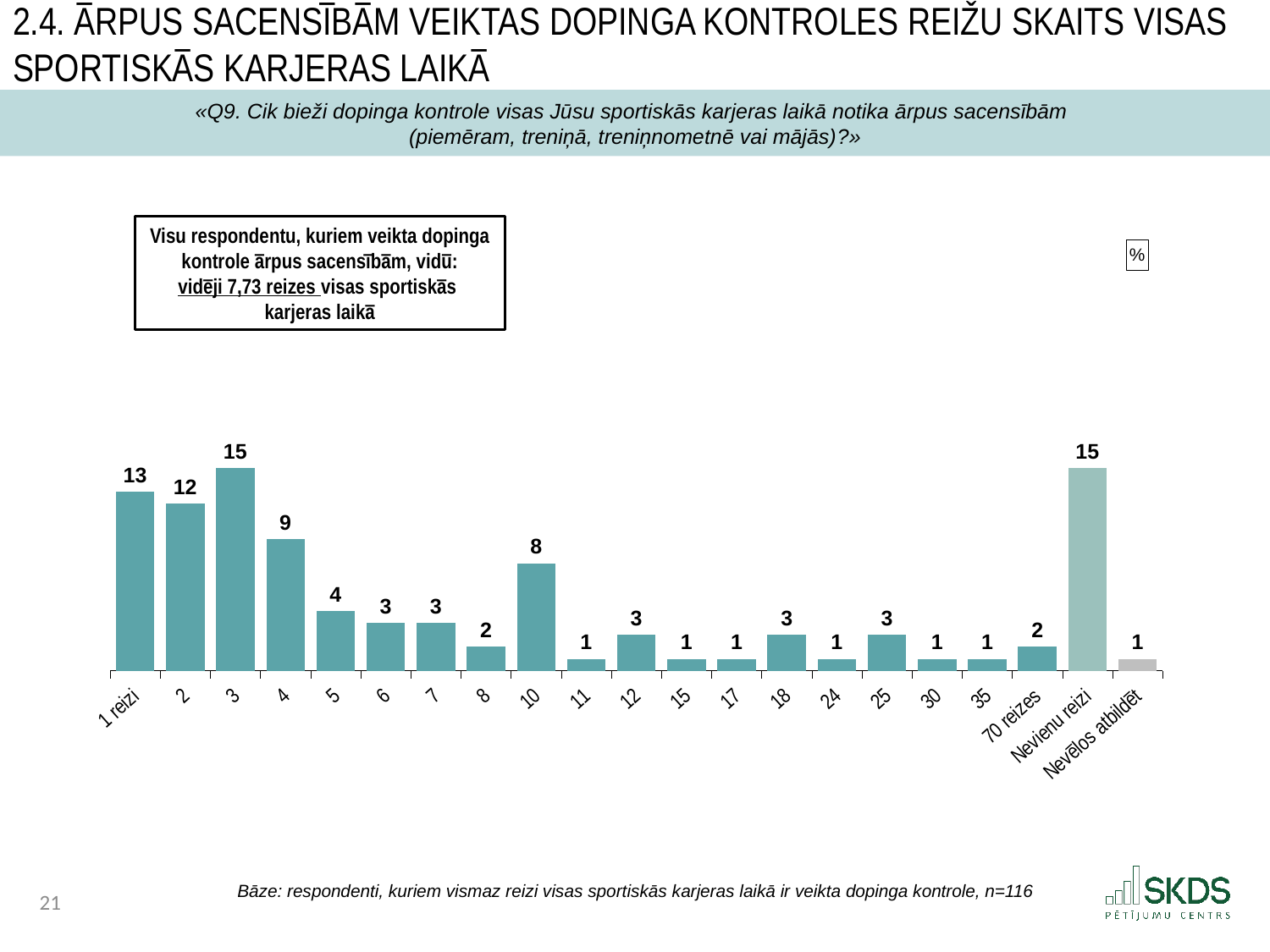
What kind of chart is shown on the slide? bar chart Which is larger, the value for "5" or the value for "8"? 5 What is the value for the category "Nevienu reizi"? 15 What is the value for the category "10"? 8 What is the average number of out-of-competition doping controls stated in the text box on the slide? 7,73 reizes What is the difference between the values for "1 reizi" and "2"? 1 What is the value for the category "1 reizi"? 13 What is the difference between the values for "3" and "4"? 6 How many categories are shown on the x axis of the chart? 21 Which is larger, the value for "4" or the value for "10"? 4 What is the value for the category "Nevēlos atbildēt"? 1 What is the value for the category "70 reizes"? 2